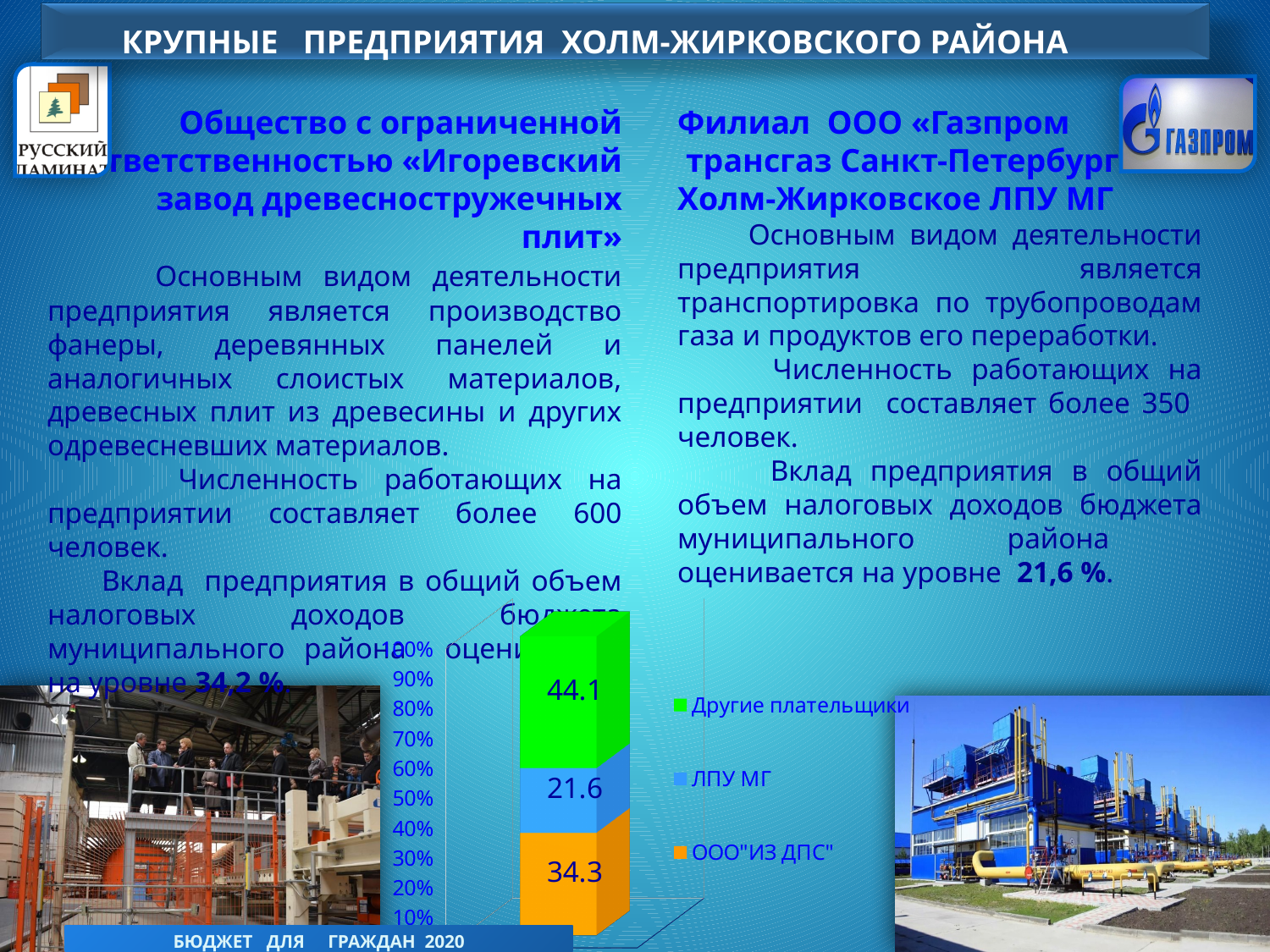
What is the difference between the Другие плательщики value and the ООО"ИЗ ДПС" value? 9.8 How many series does the chart legend list? 3 What value is shown for the Другие плательщики segment of the stacked bar? 44.1 What colour represents ЛПУ МГ in the chart? Blue Which legend series has the largest value in the stacked bar? Другие плательщики What is the difference between the ООО"ИЗ ДПС" value and the ЛПУ МГ value? 12.7 What value is shown for the ЛПУ МГ segment of the stacked bar? 21.6 What value is shown for the ООО"ИЗ ДПС" segment of the stacked bar? 34.3 Which is larger, the value for ООО"ИЗ ДПС" or the value for ЛПУ МГ? ООО"ИЗ ДПС" Which legend series has the smallest value in the stacked bar? ЛПУ МГ What is the total of the three segments in the stacked bar? 100.0 What kind of chart is shown on the slide? Stacked bar chart